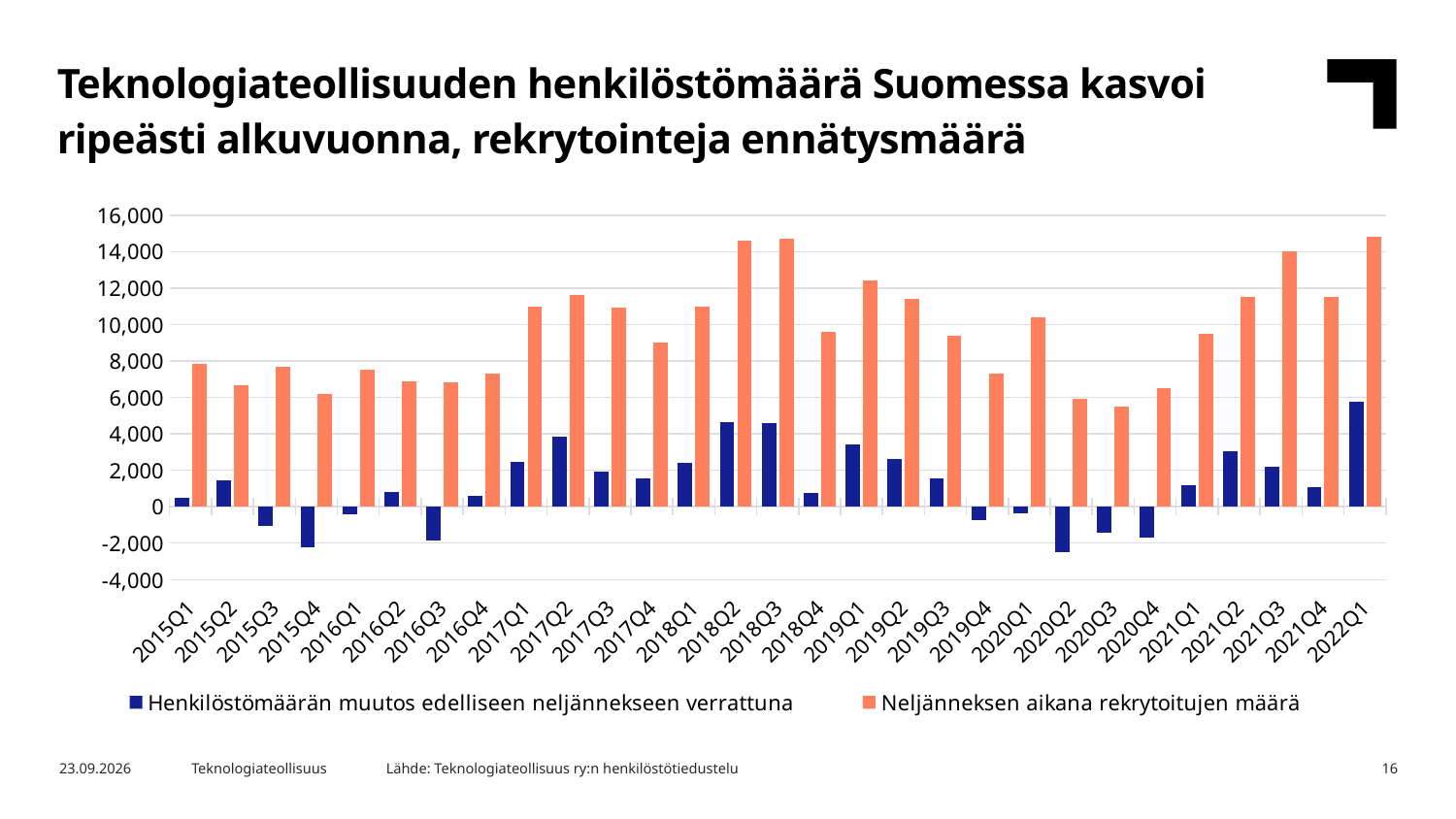
Is the value for Henkilöstömäärän muutos edelliseen neljännekseen verrattuna in 2016Q3 greater or less than 0? less Which is larger for Henkilöstömäärän muutos edelliseen neljännekseen verrattuna: 2022Q1 or 2018Q2? 2022Q1 Which quarter has the highest value for Henkilöstömäärän muutos edelliseen neljännekseen verrattuna? 2022Q1 Is the value for Henkilöstömäärän muutos edelliseen neljännekseen verrattuna in 2022Q1 greater or less than 4,000? greater How many quarters are shown on the x axis? 29 Do the values for Neljänneksen aikana rekrytoitujen määrä rise or fall from 2020Q3 to 2021Q3? rise Is the value for Neljänneksen aikana rekrytoitujen määrä in 2020Q3 greater or less than 6,000? less What kind of chart is shown on the slide? bar chart Which is larger for Neljänneksen aikana rekrytoitujen määrä: 2021Q3 or 2021Q2? 2021Q3 What colour are the bars for Neljänneksen aikana rekrytoitujen määrä? orange How many series does the legend list? 2